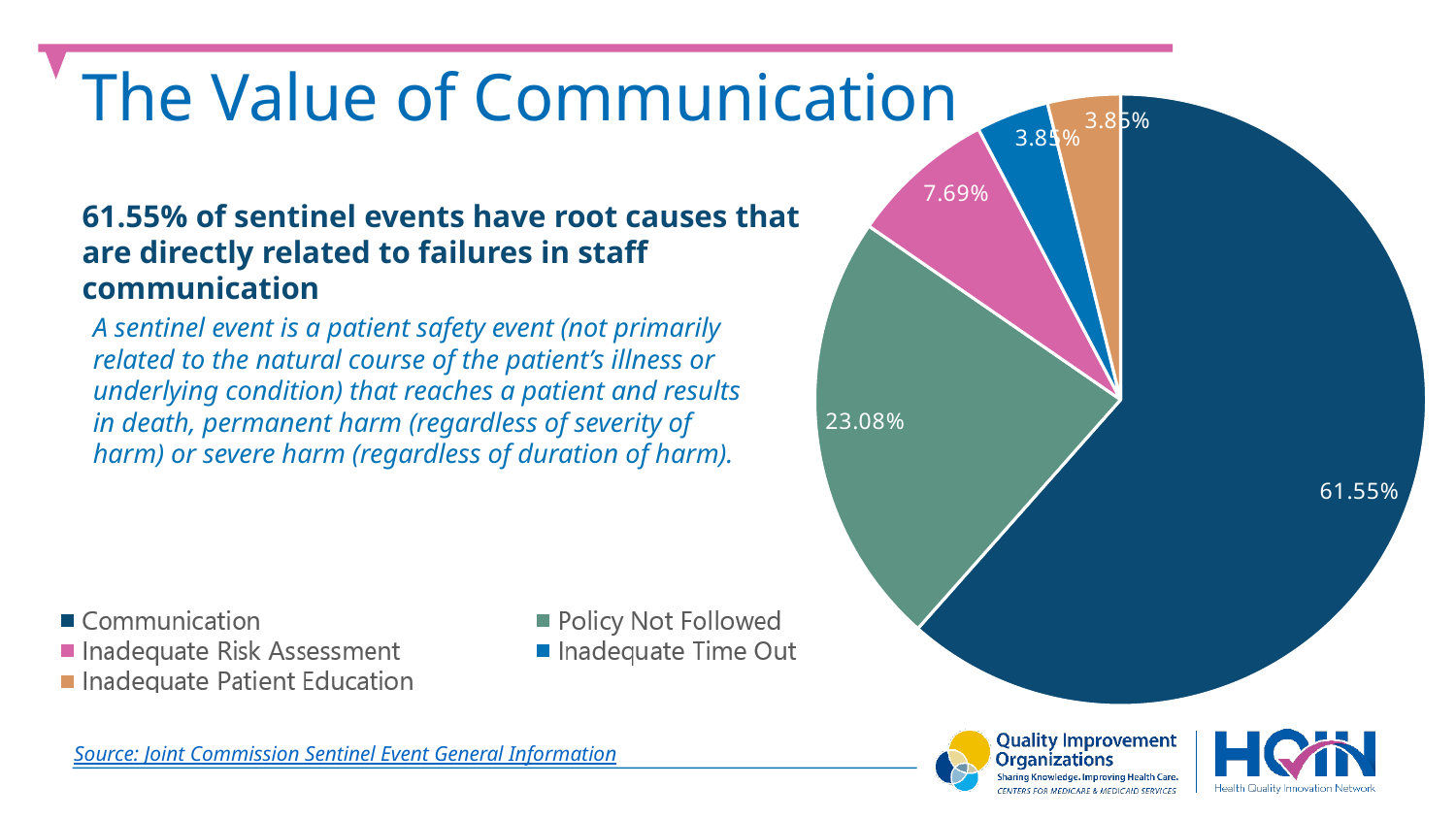
What is the value shown for Inadequate Time Out? 3.85% How many entries does the legend list? 5 What colour represents Inadequate Risk Assessment in the pie chart? Pink What is the value shown for Inadequate Patient Education? 3.85% What is the difference between the Communication and Policy Not Followed values? 38.47% Which is larger, Policy Not Followed or Inadequate Risk Assessment? Policy Not Followed What is the value shown for Policy Not Followed? 23.08% What share of the pie does Communication account for? 61.55% How many categories does the pie chart show? 5 What is the value shown for Inadequate Risk Assessment? 7.69% Which category has the largest slice of the pie? Communication What type of chart is shown on the slide? Pie chart